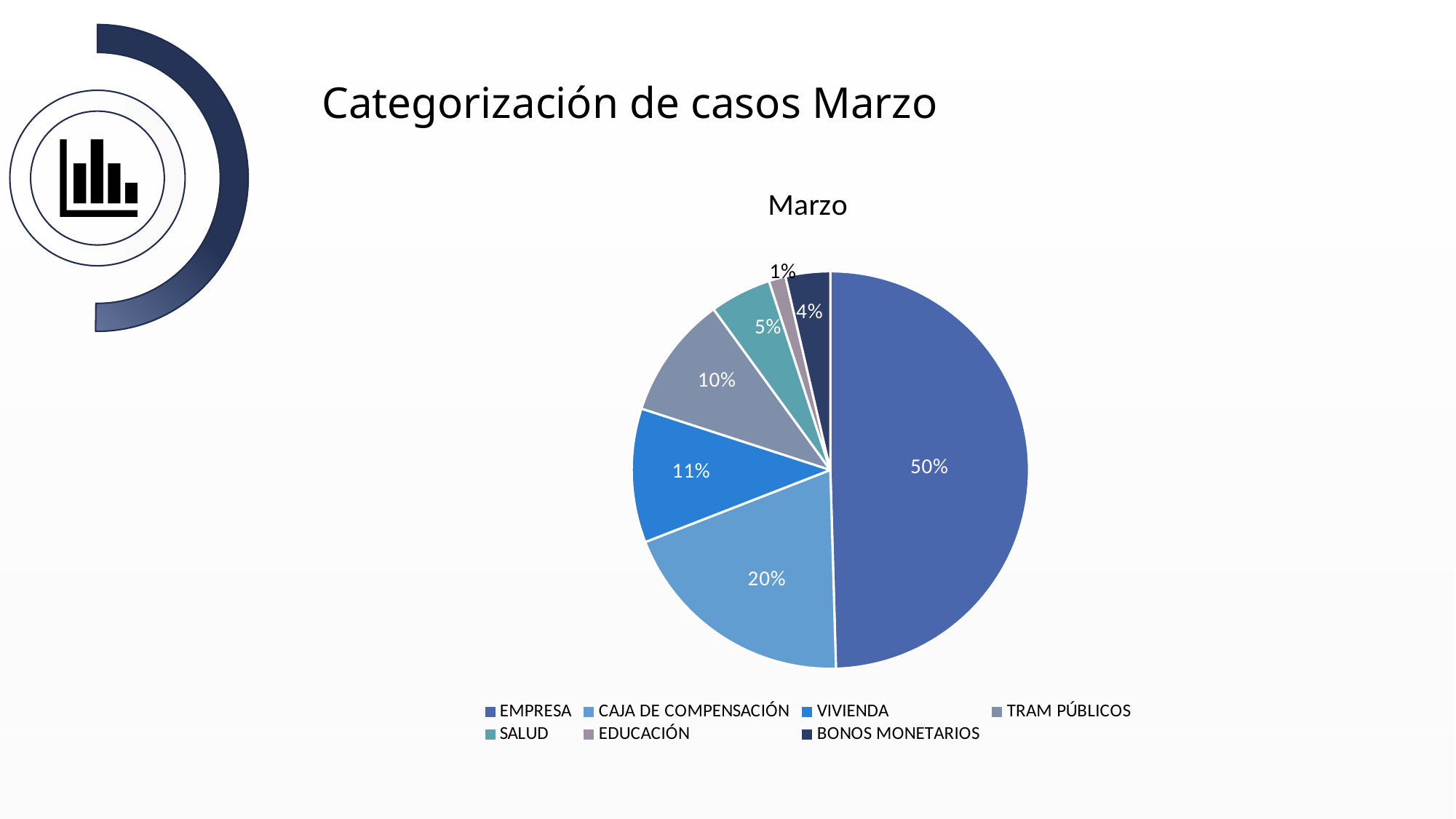
Which is larger, the share for SALUD or the share for BONOS MONETARIOS? SALUD Which category has the smallest slice of the pie? EDUCACIÓN What is the value for VIVIENDA? 11% Which category has the largest slice of the pie? EMPRESA What kind of chart is shown on the slide? pie chart What is the title of the chart? Marzo What is the value for TRAM PÚBLICOS? 10% What is the value for BONOS MONETARIOS? 4% What share of the pie does CAJA DE COMPENSACIÓN have? 20% What is the difference between the shares of EMPRESA and CAJA DE COMPENSACIÓN? 30% How many categories does the legend list? 7 What share of the pie does EMPRESA have? 50%